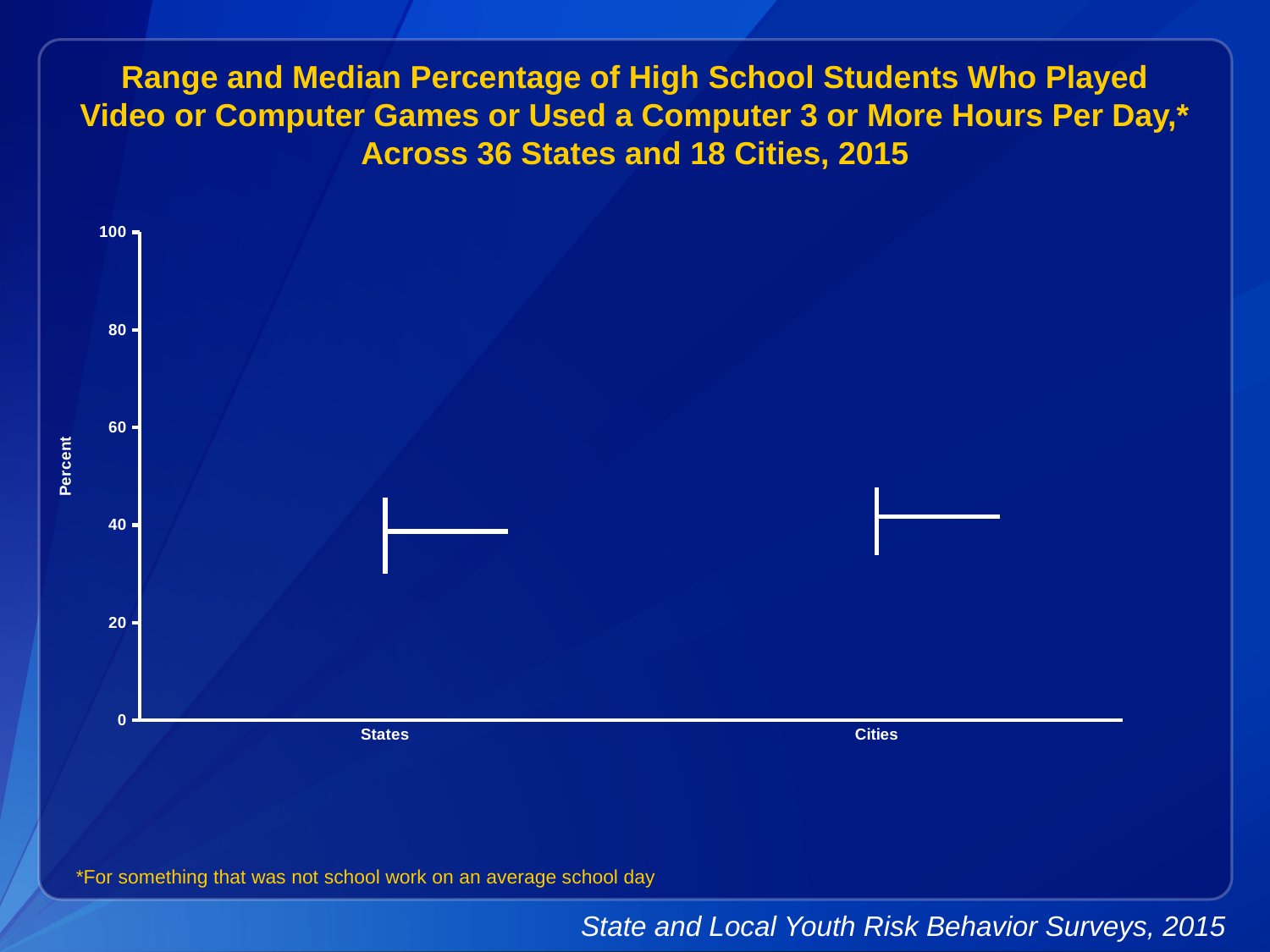
Is the top of the range for Cities greater or less than 60? less What is the highest value shown on the y axis? 100 How many categories are shown on the x axis of the chart? 2 What is the label of the y axis? Percent Is the bottom of the range for States greater or less than 20? greater Is the median value for States greater or less than 60? less What are the two categories shown on the x axis? States and Cities Which category has the higher median value, States or Cities? Cities